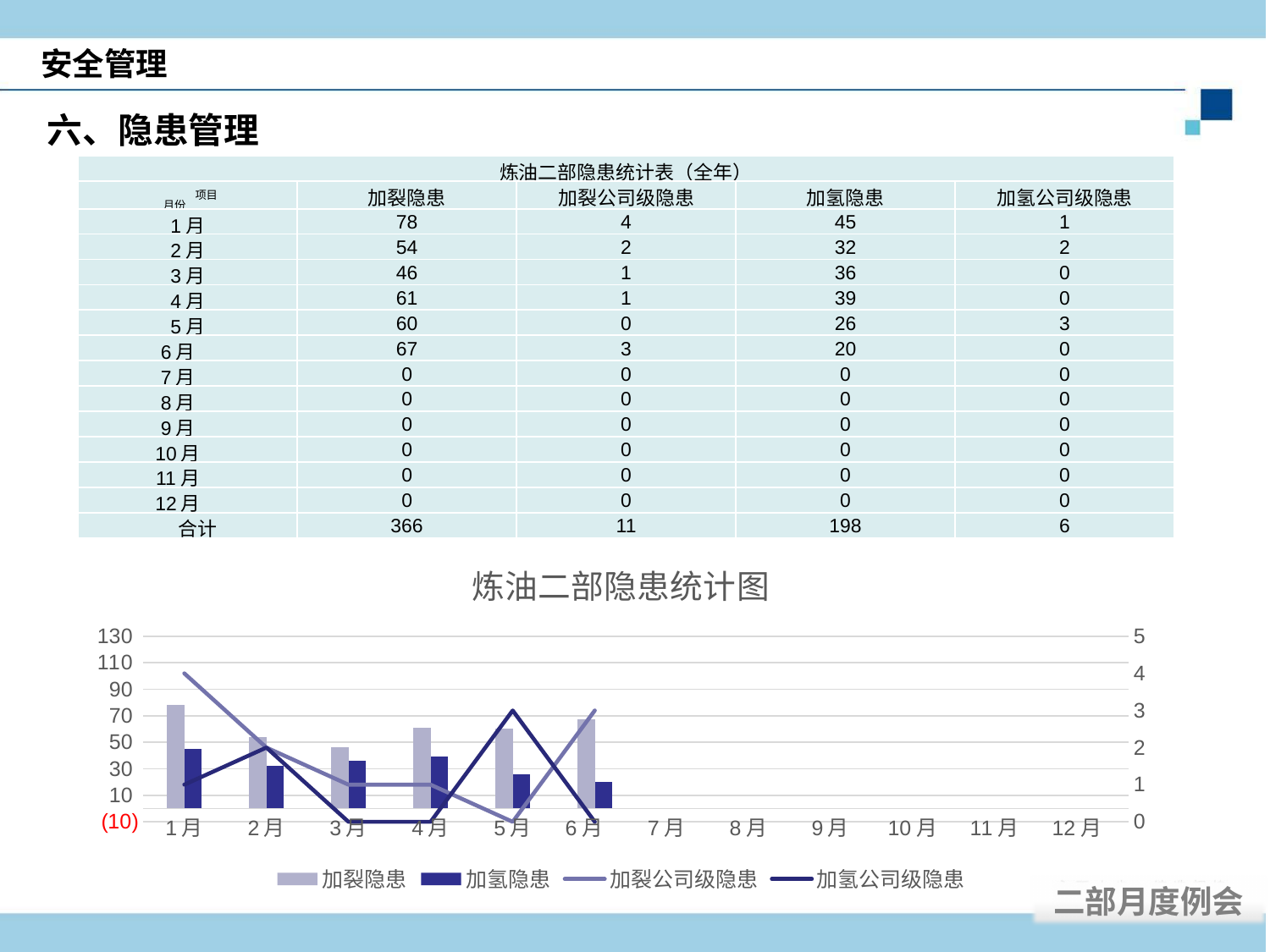
In the 炼油二部隐患统计图, which is larger for 1月: 加裂隐患 or 加氢隐患? 加裂隐患 In the 炼油二部隐患统计图, is the 加裂隐患 value for 4月 greater or less than 50? greater How many series does the legend of the 炼油二部隐患统计图 list? 4 What kind of chart is the 炼油二部隐患统计图? A combination bar and line chart How many months are shown on the x axis of the 炼油二部隐患统计图? 12 What is the maximum value shown on the right-hand axis of the 炼油二部隐患统计图? 5 In the 炼油二部隐患统计图, which month has the highest 加裂隐患 bar? 1月 In the 炼油二部隐患统计图, what is the value of 加裂隐患 for 1月? 78 In the 炼油二部隐患统计图, which month has the highest 加氢隐患 bar? 1月 In the 炼油二部隐患统计图, what is the value of 加氢公司级隐患 for 5月? 3 In the 炼油二部隐患统计图, what is the difference between 加裂隐患 and 加氢隐患 for 1月? 33 In the 炼油二部隐患统计图, does the 加裂公司级隐患 line rise or fall from 1月 to 5月? fall